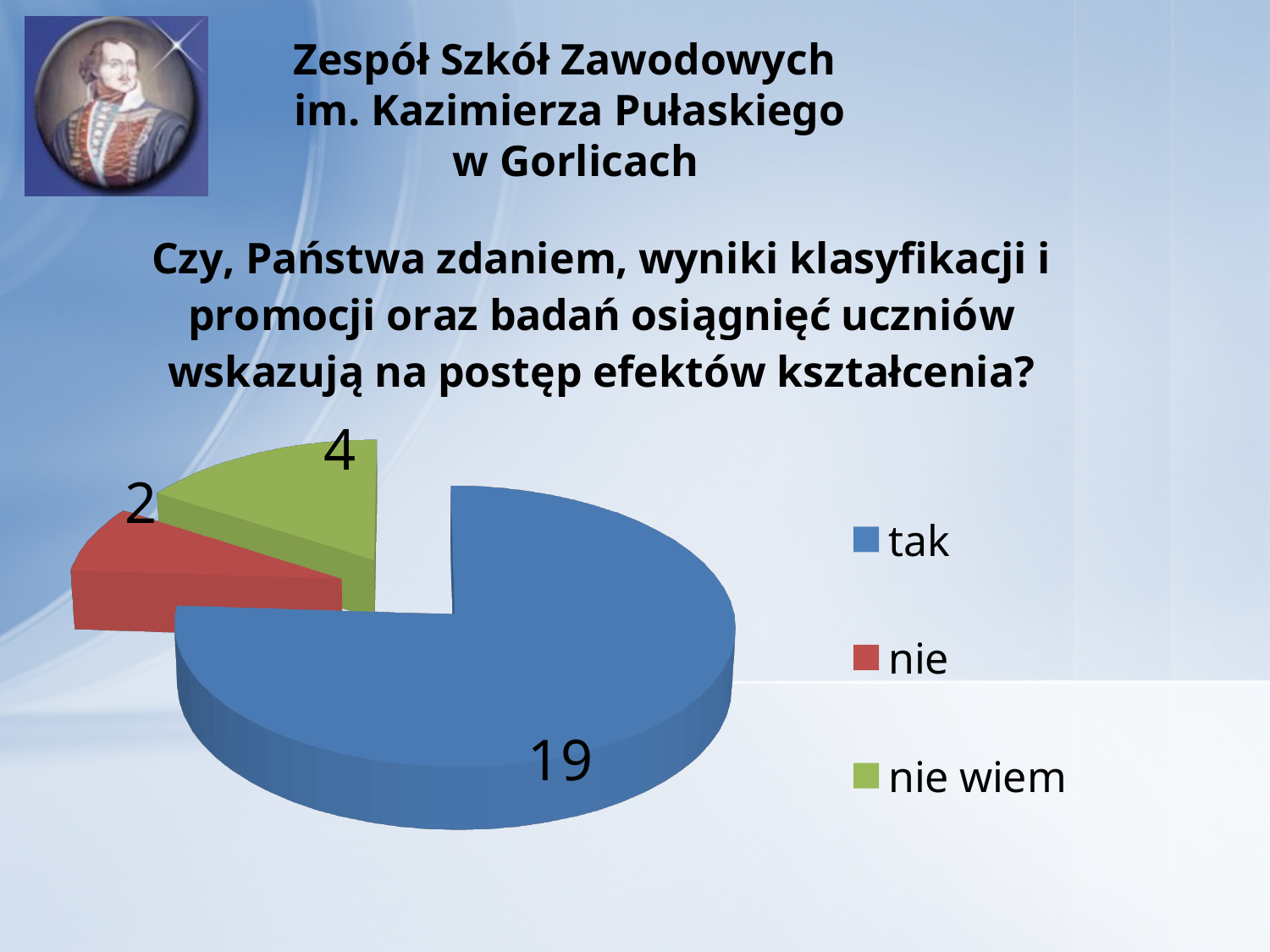
What is the value for "nie"? 2 What is the difference between the values for "tak" and "nie wiem"? 15 What share of the pie does the "tak" slice represent? 76% How many categories does the pie chart have? 3 What is the value for "tak"? 19 What is the value for "nie wiem"? 4 What is the difference between the values for "nie wiem" and "nie"? 2 Which category has the smallest slice? nie Which category has the largest slice? tak Which is larger, the value for "nie" or the value for "nie wiem"? nie wiem What colour is the "nie wiem" slice? green What kind of chart is shown on the slide? pie chart